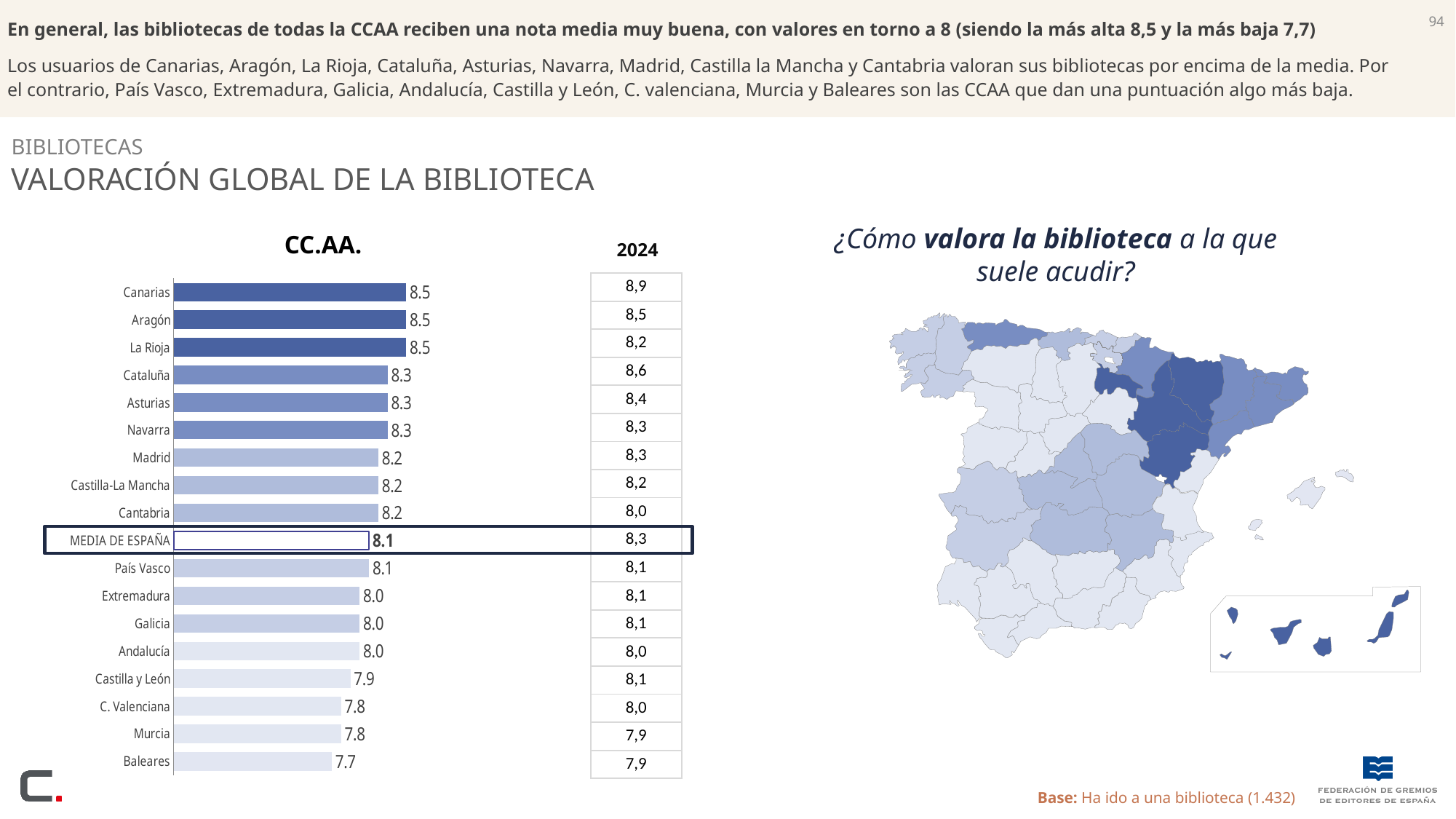
What type of chart is shown under the heading CC.AA.? bar chart What is the difference between the values for Navarra and Murcia in the CC.AA. bar chart? 0.5 What is the highest value shown in the CC.AA. bar chart? 8.5 What is the value for MEDIA DE ESPAÑA in the CC.AA. bar chart? 8.1 In the CC.AA. bar chart, which has the larger value, Cataluña or Galicia? Cataluña Which category has the lowest value in the CC.AA. bar chart? Baleares What is the value for Canarias in the CC.AA. bar chart? 8.5 What is the value for Baleares in the CC.AA. bar chart? 7.7 What is the difference between the values for Canarias and Baleares in the CC.AA. bar chart? 0.8 What is the value for Madrid in the CC.AA. bar chart? 8.2 Which bar in the CC.AA. bar chart is outlined with a dark box? MEDIA DE ESPAÑA How many bars are shown in the CC.AA. bar chart, including MEDIA DE ESPAÑA? 18